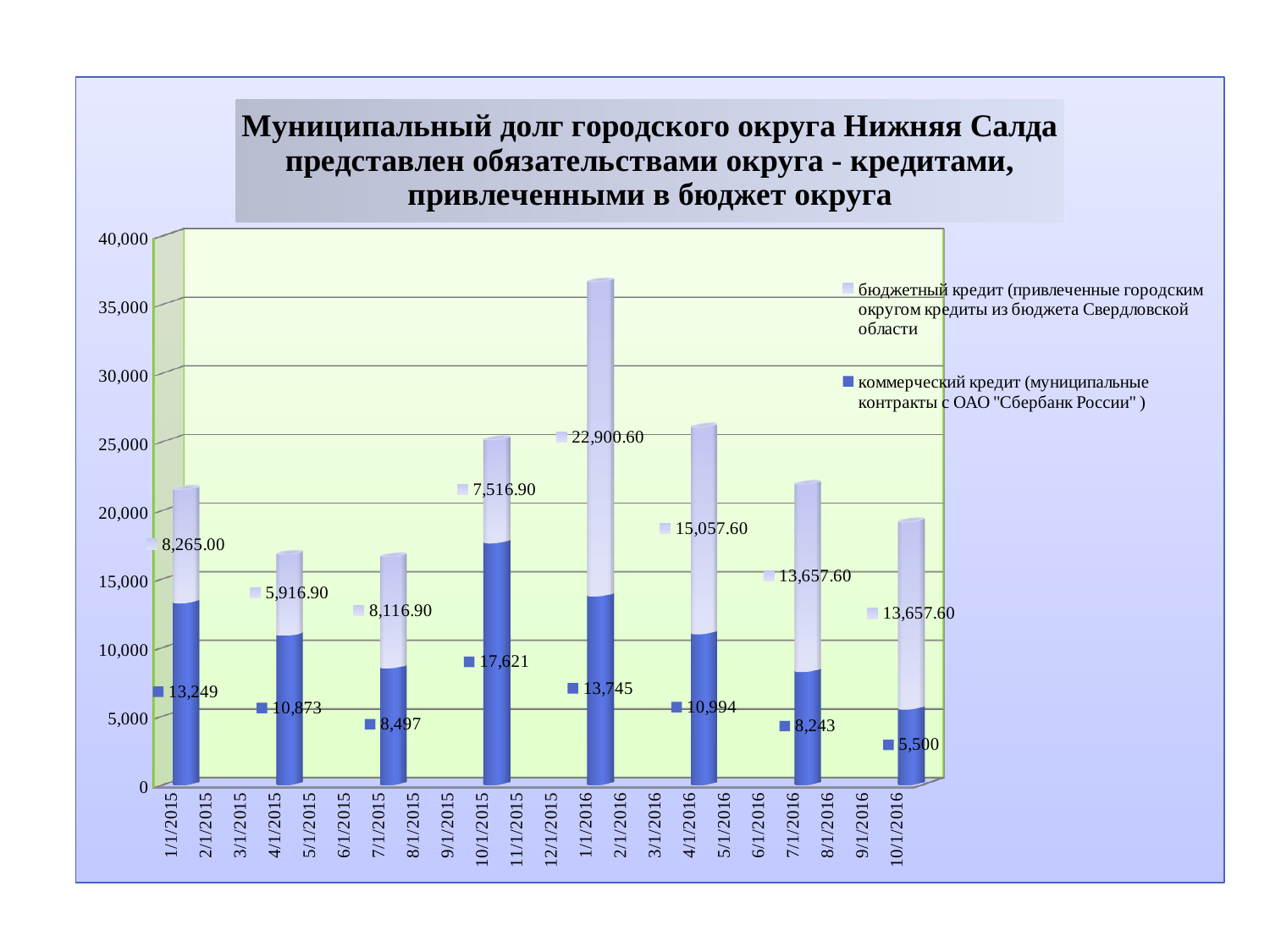
On which date is the коммерческий кредит value the highest? 10/1/2015 What is the total of the stacked bar for 1/1/2016? 36,645.60 Which is larger: the бюджетный кредит value for 4/1/2016 or for 7/1/2016? 4/1/2016 What is the value of бюджетный кредит for 4/1/2015? 5,916.90 What is the value of коммерческий кредит for 10/1/2016? 5,500 On which date is the бюджетный кредит value the lowest? 4/1/2015 What is the value of коммерческий кредит for 10/1/2015? 17,621 How many dates have bars plotted in the chart? 8 What is the difference between the коммерческий кредит values for 1/1/2015 and 4/1/2015? 2,376 What is the value of бюджетный кредит for 1/1/2016? 22,900.60 What kind of chart is shown on the slide? Stacked bar chart How many series does the legend list? 2